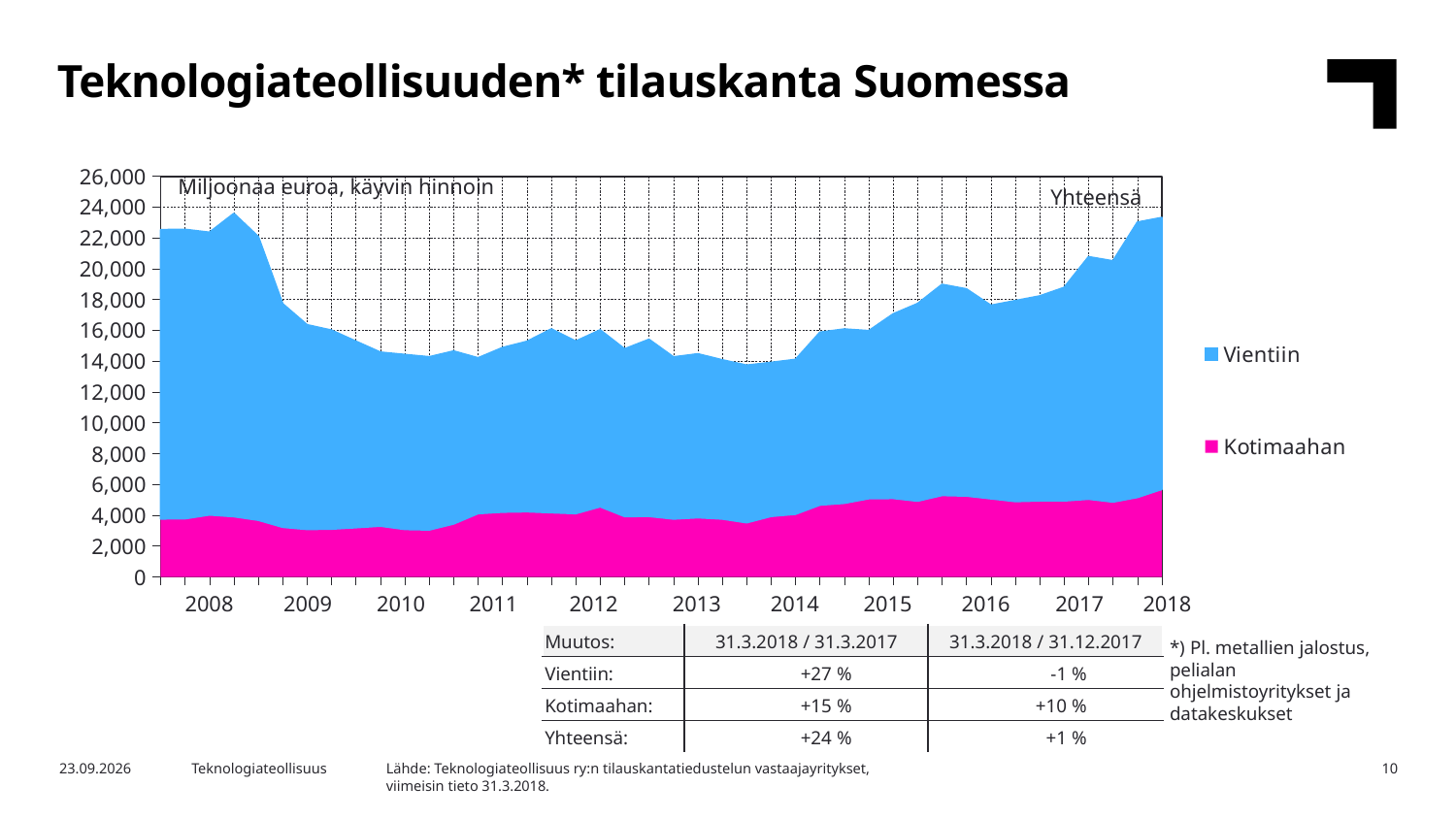
Is the Kotimaahan value in 2010 greater or less than 4,000? less Is the total (Yhteensä) value at the start of 2008 greater or less than 20,000? greater What unit label is shown inside the chart area? Miljoonaa euroa, käyvin hinnoin Does the total (Yhteensä) value rise or fall from 2016 to 2018? rise Which two series are listed in the chart legend? Vientiin and Kotimaahan How many year labels are shown on the x axis? 11 What kind of chart is shown on the slide? Stacked area chart How many series does the chart legend list? 2 Which series is larger in 2018, Vientiin or Kotimaahan? Vientiin Is the total (Yhteensä) value at the end of the series in 2018 greater or less than 20,000? greater Does the total (Yhteensä) value rise or fall from 2008 to 2010? fall